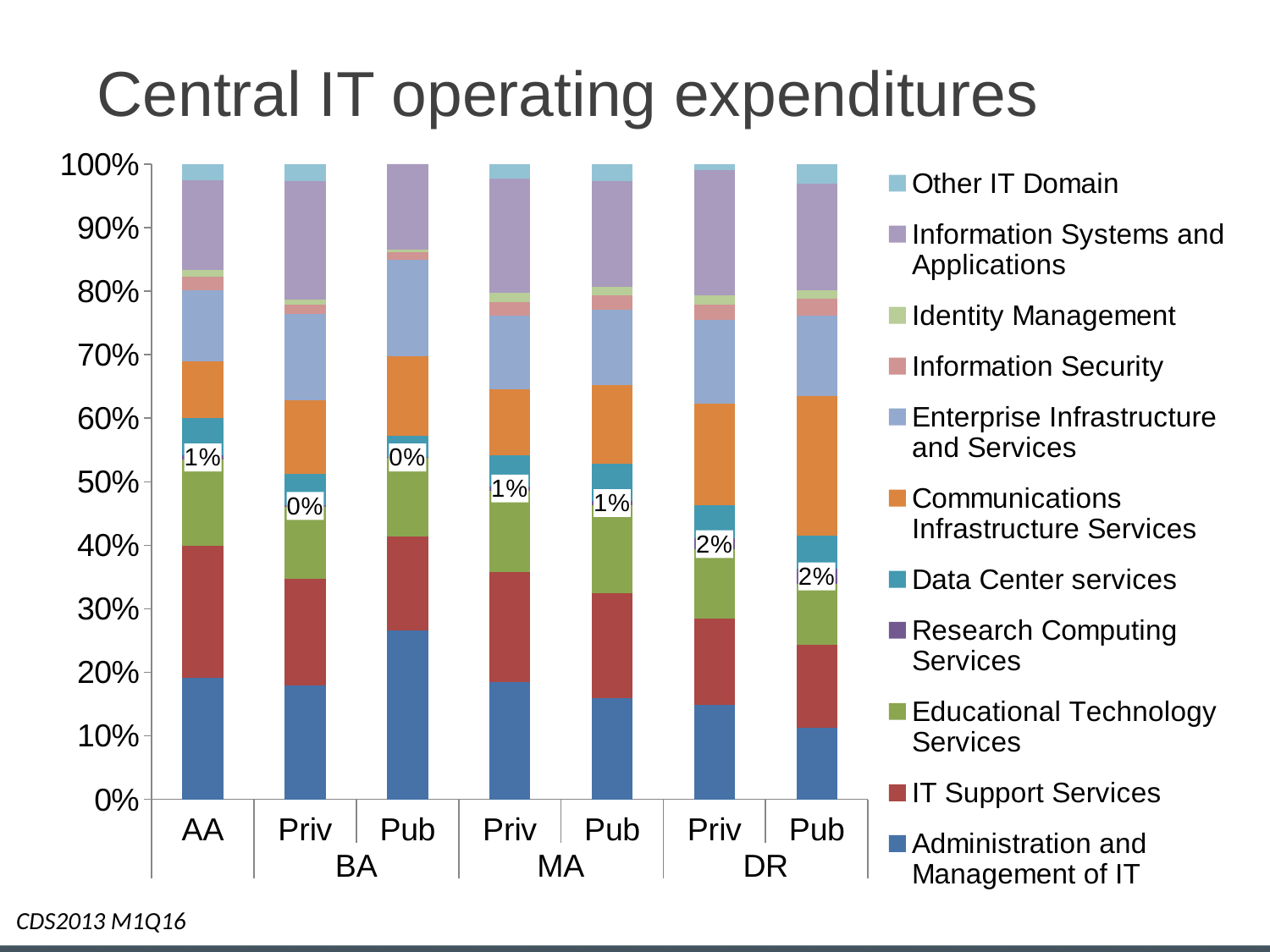
What kind of chart is shown on the slide? stacked bar chart What is the labelled value for Research Computing Services in the DR Priv bar? 2% Is the Administration and Management of IT share for DR Pub greater or less than 20%? less Which is larger, the Research Computing Services value for DR Priv or for AA? DR Priv What is the labelled value for Research Computing Services in the AA bar? 1% What is the labelled value for Research Computing Services in the MA Pub bar? 1% What is the difference between the Research Computing Services values for DR Pub and BA Pub? 2% How many series does the legend list? 11 What is the labelled value for Research Computing Services in the BA Priv bar? 0% How many bars are plotted in the chart? 7 What is the title of the chart? Central IT operating expenditures Is the Administration and Management of IT share for BA Pub greater or less than 20%? greater